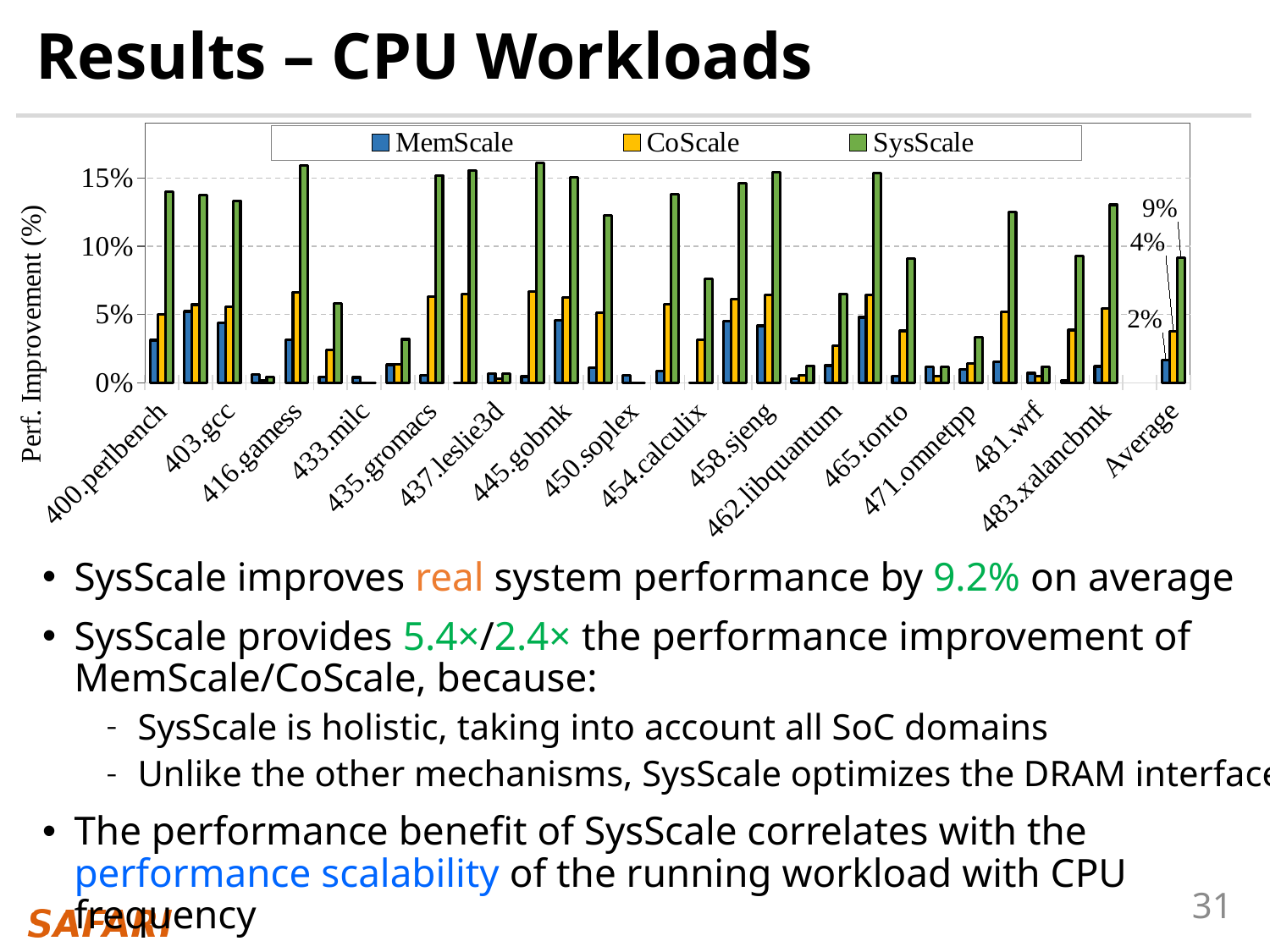
What kind of chart is shown on the slide? bar chart What is the CoScale value for Average? 4% Which series has the highest value for Average? SysScale What is the difference between the SysScale and MemScale values for Average? 7% For Average, which is larger: the CoScale value or the SysScale value? SysScale Is the SysScale value for 400.perlbench greater or less than 10%? greater How many series does the legend list? 3 What are the three series named in the legend? MemScale, CoScale, SysScale What is the label of the y axis? Perf. Improvement (%) What is the SysScale value for Average? 9% What is the MemScale value for Average? 2% Which series has the lowest value for Average? MemScale